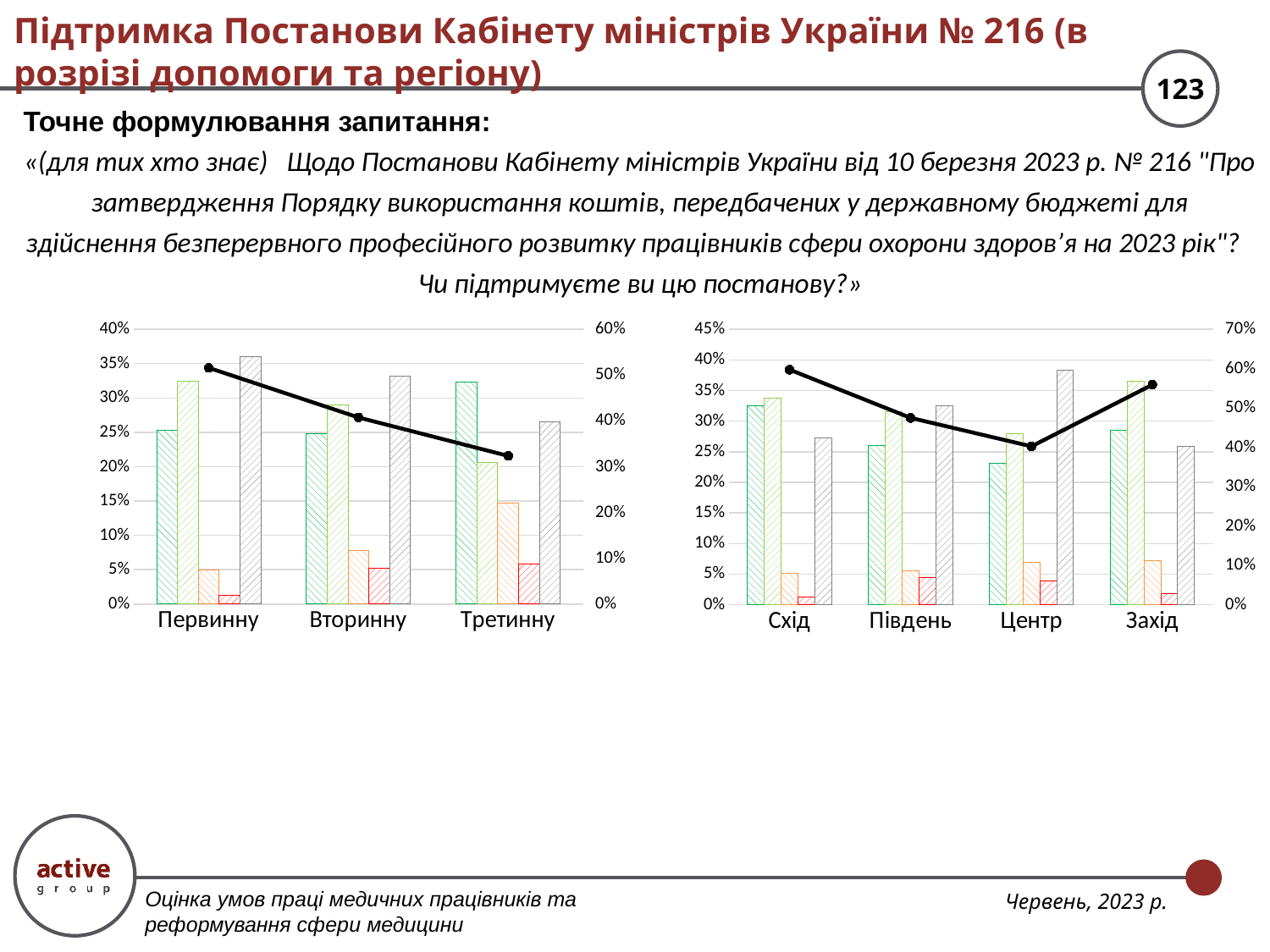
What are the category labels on the x axis of the right chart? Схід, Південь, Центр, Захід In the right chart, at which category is the black line lowest? Центр In the left chart, is the black line value for Первинну (right axis) greater or less than 40%? greater How many categories are shown on the x axis of the left chart? 3 What kind of chart is the left chart (Первинну, Вторинну, Третинну)? bar chart with a line In the right chart, is the black line value for Схід (right axis) greater or less than 50%? greater In the left chart, does the black line rise or fall from Первинну to Третинну? falls In the left chart, is the black line value for Третинну (right axis) greater or less than 40%? less In the left chart, at which category is the black line highest? Первинну In the left chart, which has the larger black line value, Первинну or Третинну? Первинну In the right chart, which has the larger black line value, Схід or Центр? Схід How many categories are shown on the x axis of the right chart (Схід, Південь, Центр, Захід)? 4